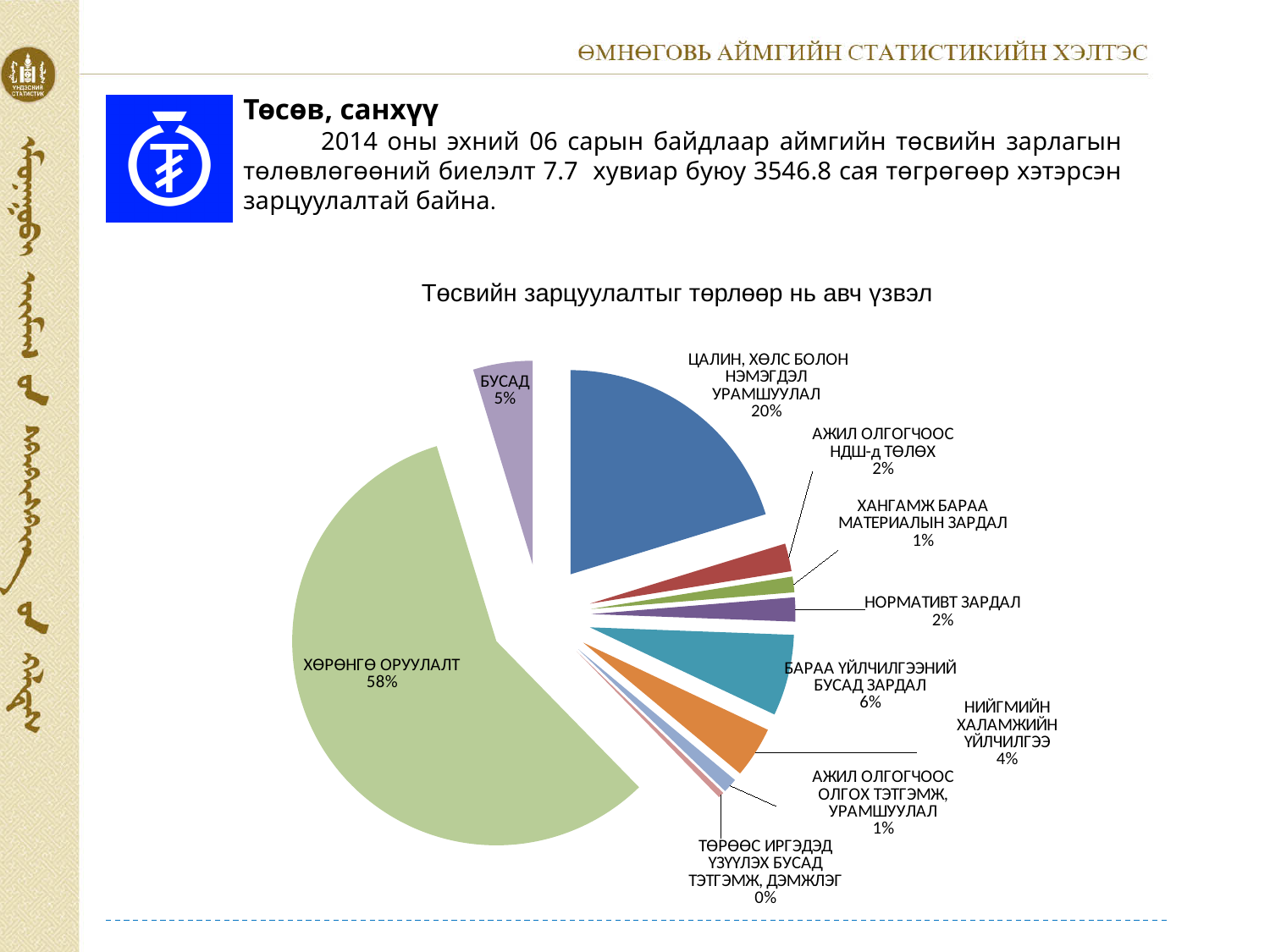
How many categories (slices) are shown in the pie chart? 10 What is the difference between the shares of ХӨРӨНГӨ ОРУУЛАЛТ and ЦАЛИН, ХӨЛС БОЛОН НЭМЭГДЭЛ УРАМШУУЛАЛ? 38% What is the value shown for БАРАА ҮЙЛЧИЛГЭЭНИЙ БУСАД ЗАРДАЛ? 6% What type of chart is shown on the slide? Pie chart Which category has the largest share of the pie? ХӨРӨНГӨ ОРУУЛАЛТ Which is larger, the share for БАРАА ҮЙЛЧИЛГЭЭНИЙ БУСАД ЗАРДАЛ or the share for НИЙГМИЙН ХАЛАМЖИЙН ҮЙЛЧИЛГЭЭ? БАРАА ҮЙЛЧИЛГЭЭНИЙ БУСАД ЗАРДАЛ What share of the pie does ЦАЛИН, ХӨЛС БОЛОН НЭМЭГДЭЛ УРАМШУУЛАЛ represent? 20% What is the title of the chart? Төсвийн зарцуулалтыг төрлөөр нь авч үзвэл Which category has the smallest share of the pie? ТӨРӨӨС ИРГЭДЭД ҮЗҮҮЛЭХ БУСАД ТЭТГЭМЖ, ДЭМЖЛЭГ What is the value shown for НИЙГМИЙН ХАЛАМЖИЙН ҮЙЛЧИЛГЭЭ? 4% What is the value shown for БУСАД? 5% What share of the pie does ХӨРӨНГӨ ОРУУЛАЛТ represent? 58%